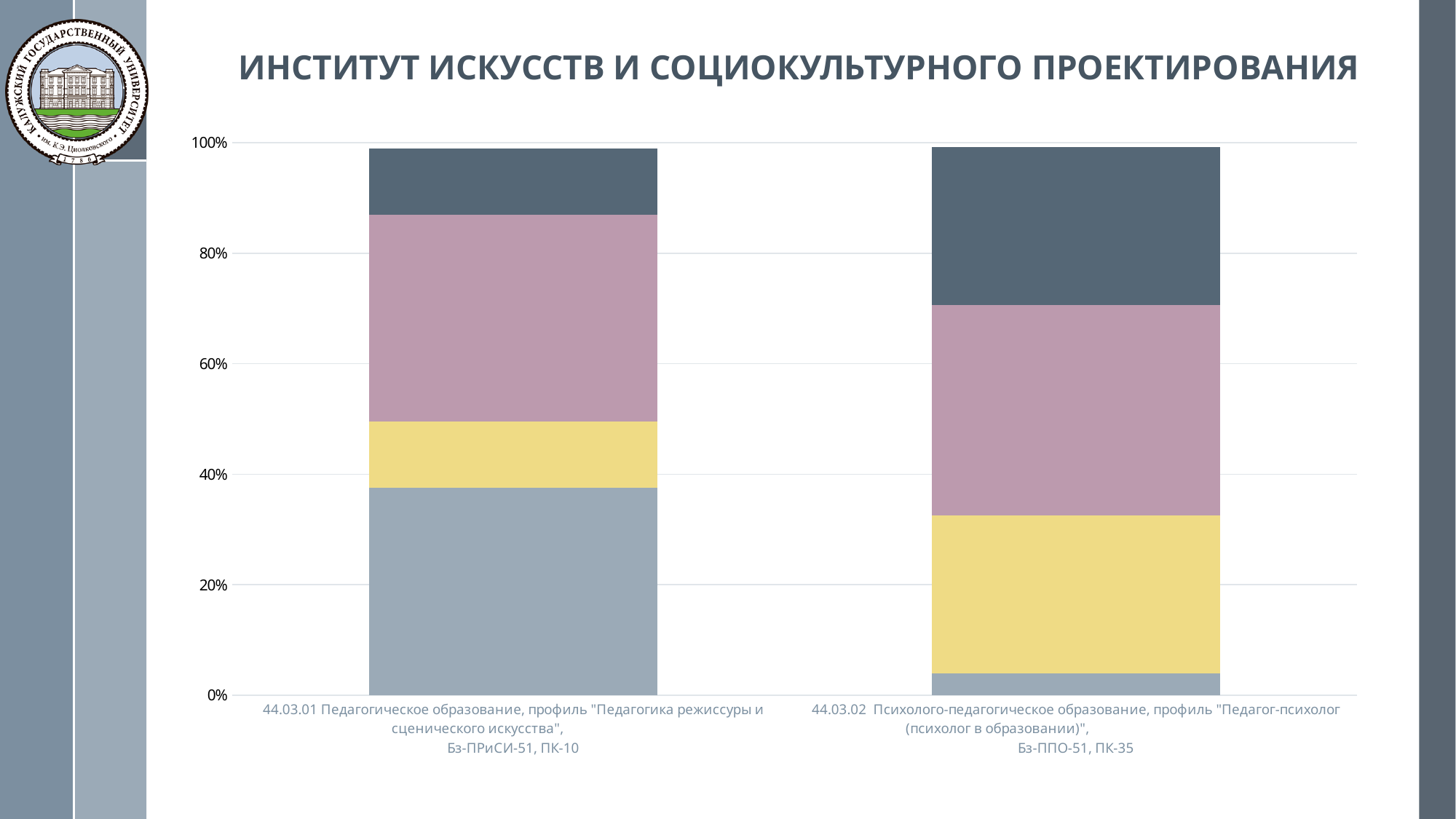
What is the heading printed above the chart? ИНСТИТУТ ИСКУССТВ И СОЦИОКУЛЬТУРНОГО ПРОЕКТИРОВАНИЯ Is the yellow segment of the bar for 44.03.02 (Бз-ППО-51, ПК-35) greater or less than 20%? greater What kind of chart is shown on the slide? Stacked bar chart How many coloured segments make up each stacked bar? 4 Is the dark grey top segment of the bar for 44.03.02 (Бз-ППО-51, ПК-35) greater or less than 20%? greater Is the light grey-blue bottom segment of the bar for 44.03.02 (Бз-ППО-51, ПК-35) greater or less than 20%? less Which bar has the larger light grey-blue bottom segment, 44.03.01 (Бз-ПРиСИ-51, ПК-10) or 44.03.02 (Бз-ППО-51, ПК-35)? 44.03.01 (Бз-ПРиСИ-51, ПК-10) How many categories (bars) are plotted on the chart? 2 Which bar has the larger dark grey top segment, 44.03.01 (Бз-ПРиСИ-51, ПК-10) or 44.03.02 (Бз-ППО-51, ПК-35)? 44.03.02 (Бз-ППО-51, ПК-35) Which bar has the larger yellow segment, 44.03.01 (Бз-ПРиСИ-51, ПК-10) or 44.03.02 (Бз-ППО-51, ПК-35)? 44.03.02 (Бз-ППО-51, ПК-35)